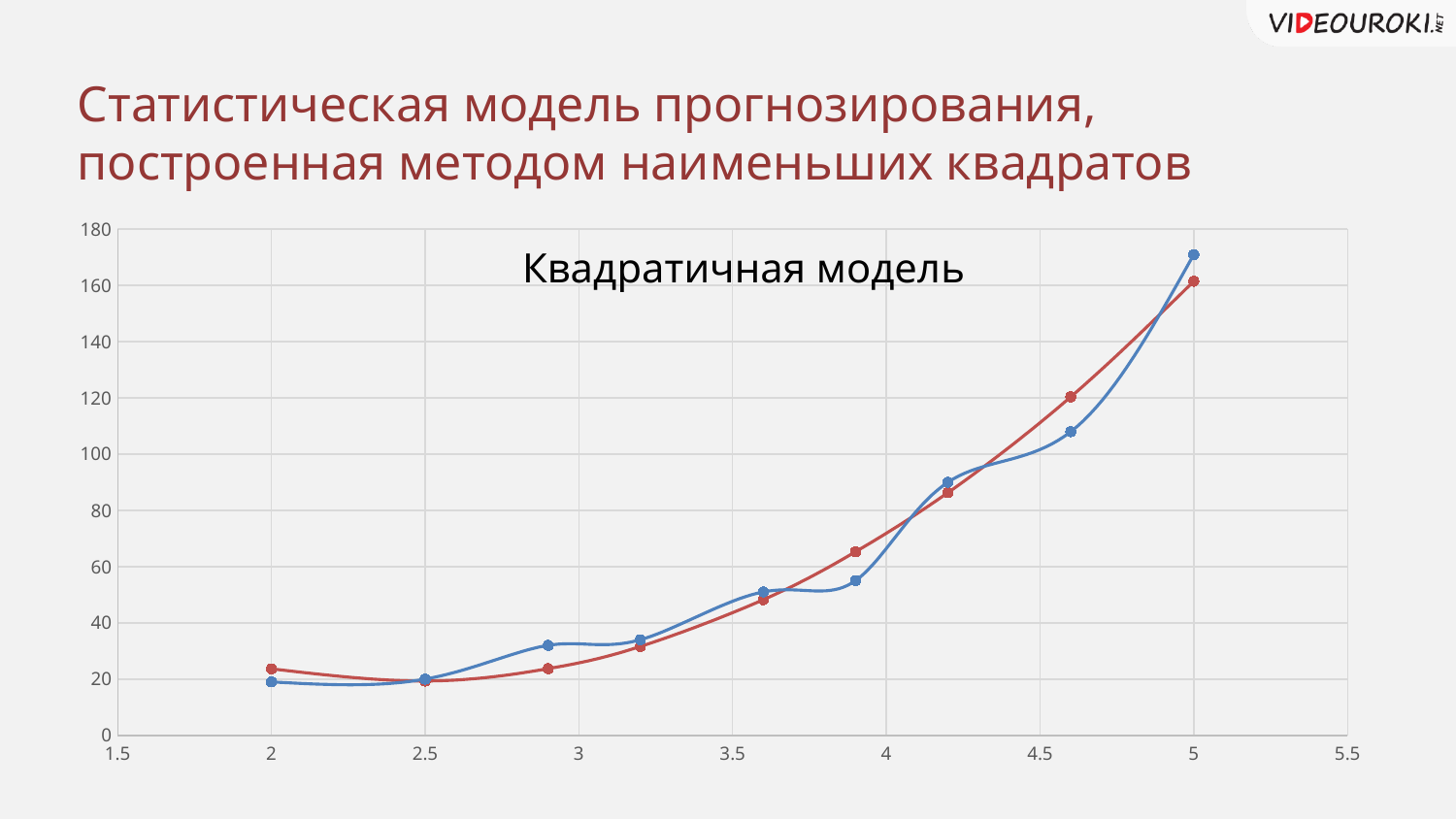
Is the value of the blue series at x = 5 greater or less than 160? greater At x = 4.6, which series has the higher value, blue or red? red Is the value of the blue series at x = 2 greater or less than 40? less How many data points does the blue series have? 9 What is the title printed inside the chart area? Квадратичная модель Is the value of the red series at x = 3.9 greater or less than 60? greater Do the values of the red series generally rise or fall as x increases from 2.5 to 5? rise What two colours are used for the two plotted series? blue and red At x = 5, which series has the higher value, blue or red? blue What kind of chart is shown on the slide? line chart At which x value does the blue series reach its highest point? 5